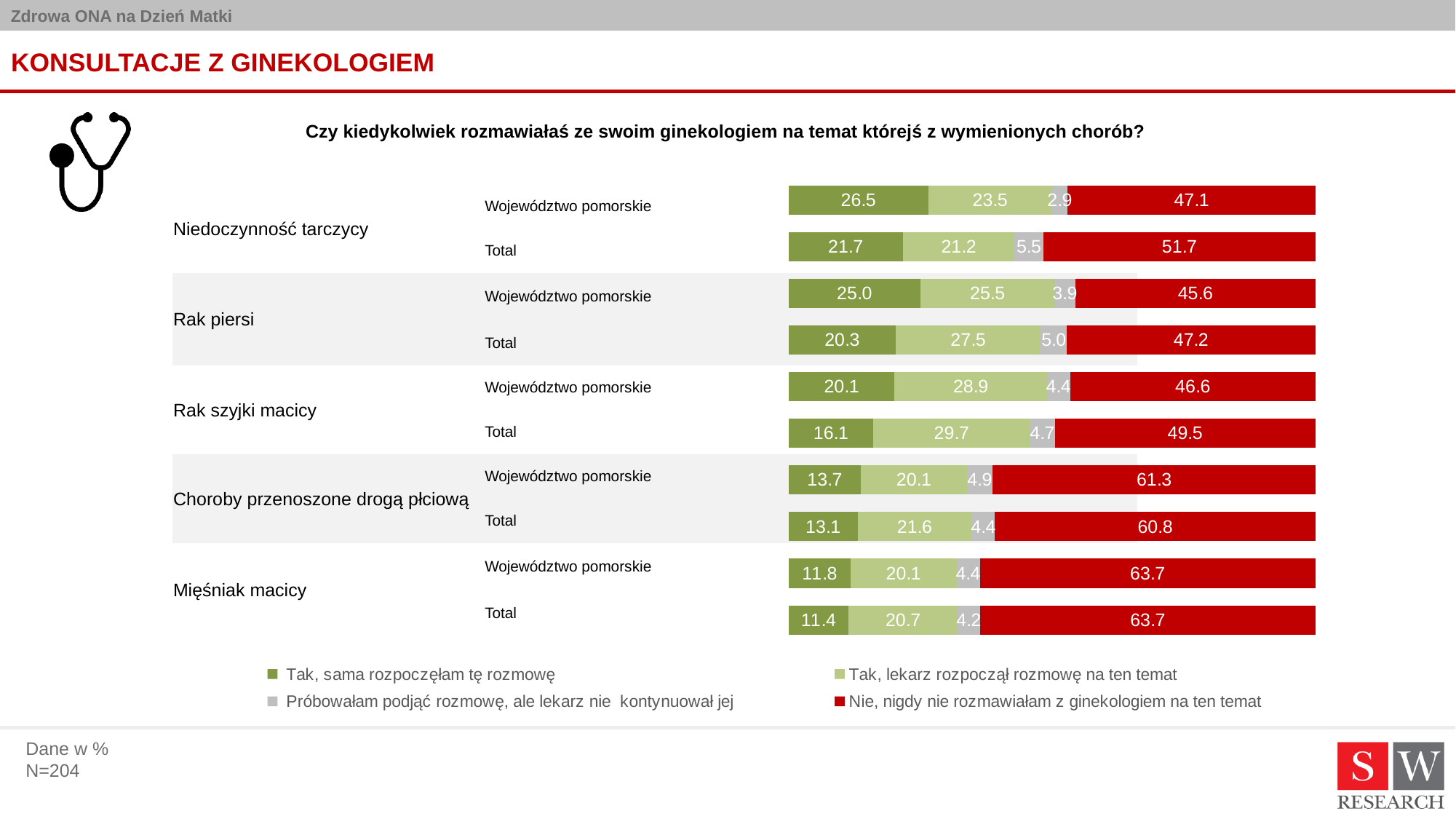
What is the value for "Nie, nigdy nie rozmawiałam z ginekologiem na ten temat" in the Województwo pomorskie bar for Niedoczynność tarczycy? 47.1 What is the total of the Total stacked bar for Rak piersi? 100.0 How many bars are plotted in the chart? 10 What kind of chart is shown on the slide? Stacked bar chart What is the value for "Próbowałam podjąć rozmowę, ale lekarz nie kontynuował jej" in the Województwo pomorskie bar for Choroby przenoszone drogą płciową? 4.9 Among the Województwo pomorskie bars, which disease has the highest value for "Nie, nigdy nie rozmawiałam z ginekologiem na ten temat"? Mięśniak macicy For Rak szyjki macicy, which bar has the larger value for "Tak, lekarz rozpoczął rozmowę na ten temat": Województwo pomorskie or Total? Total What is the value for "Tak, sama rozpoczęłam tę rozmowę" in the Total bar for Rak piersi? 20.3 How many series does the legend list? 4 Which colour represents "Nie, nigdy nie rozmawiałam z ginekologiem na ten temat" in the chart? Red Among the Total bars, which disease has the lowest value for "Tak, sama rozpoczęłam tę rozmowę"? Mięśniak macicy For Niedoczynność tarczycy, what is the difference between the Total and Województwo pomorskie values for "Nie, nigdy nie rozmawiałam z ginekologiem na ten temat"? 4.6